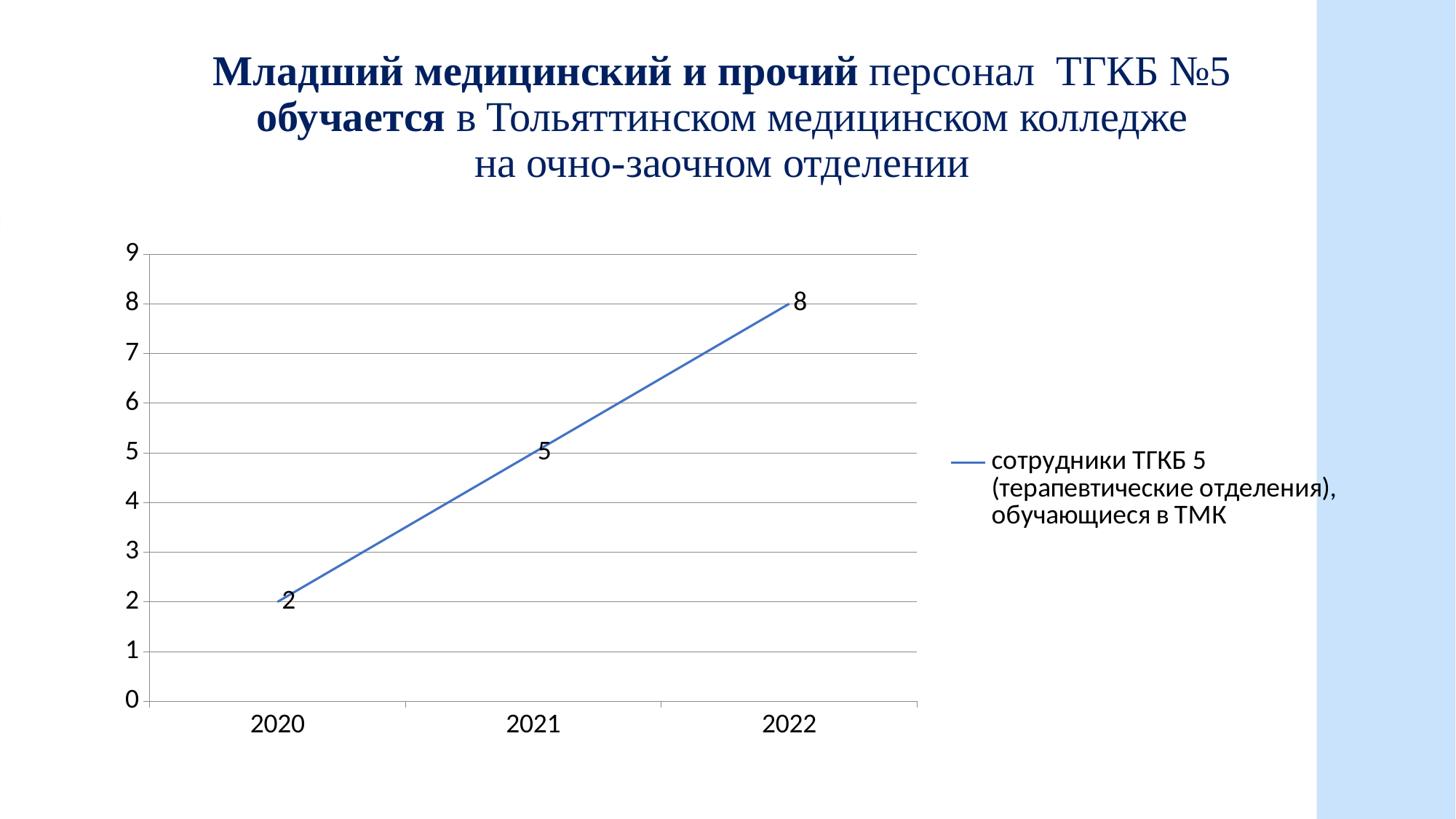
What is the difference between the values for 2022 and 2020? 6 What is the difference between the values for 2021 and 2020? 3 Which year has the lowest value? 2020 What is the value for 2022? 8 What is the value for 2021? 5 Which is larger, the value for 2021 or the value for 2022? 2022 Do the values rise or fall from 2020 to 2022? rise What kind of chart is shown? line chart Which year has the highest value? 2022 How many series does the legend list? 1 How many years are plotted on the x axis? 3 What is the value for 2020? 2